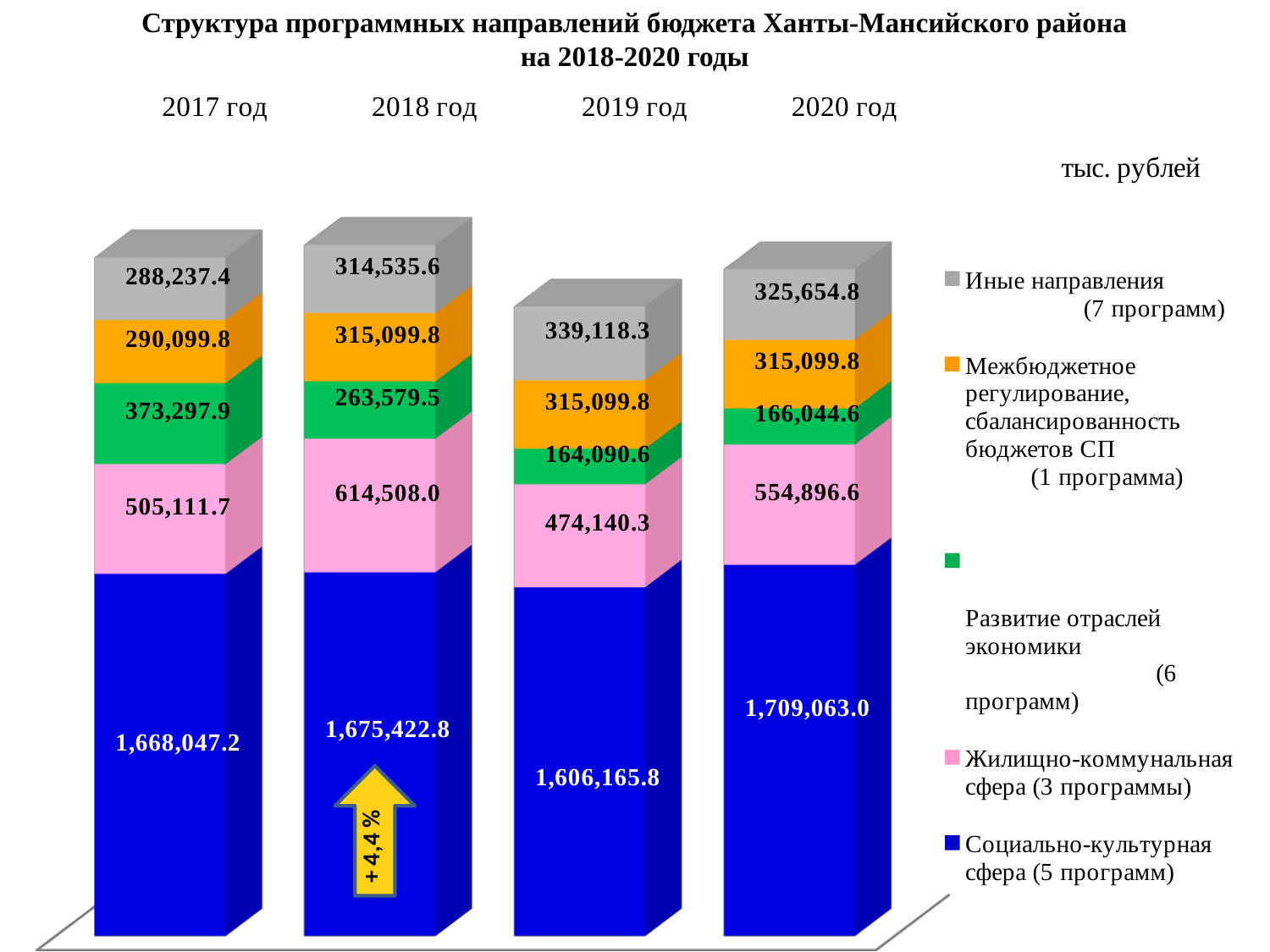
In which year is the value for Жилищно-коммунальная сфера the highest? 2018 год Which is larger: the Иные направления value for 2020 год or for 2018 год? 2020 год What is the value for Развитие отраслей экономики in 2017 год? 373,297.9 In which year is the value for Развитие отраслей экономики the lowest? 2019 год What is the value for Жилищно-коммунальная сфера in 2018 год? 614,508.0 How many series does the legend list? 5 What is the value for Иные направления in 2019 год? 339,118.3 What kind of chart is shown on the slide? Stacked bar chart What is the difference between the Социально-культурная сфера values for 2018 год and 2017 год? 7,375.6 What is the value for Социально-культурная сфера in 2020 год? 1,709,063.0 How many years (bars) are shown in the chart? 4 What is the total of the stacked bar for 2019 год? 2,898,614.8